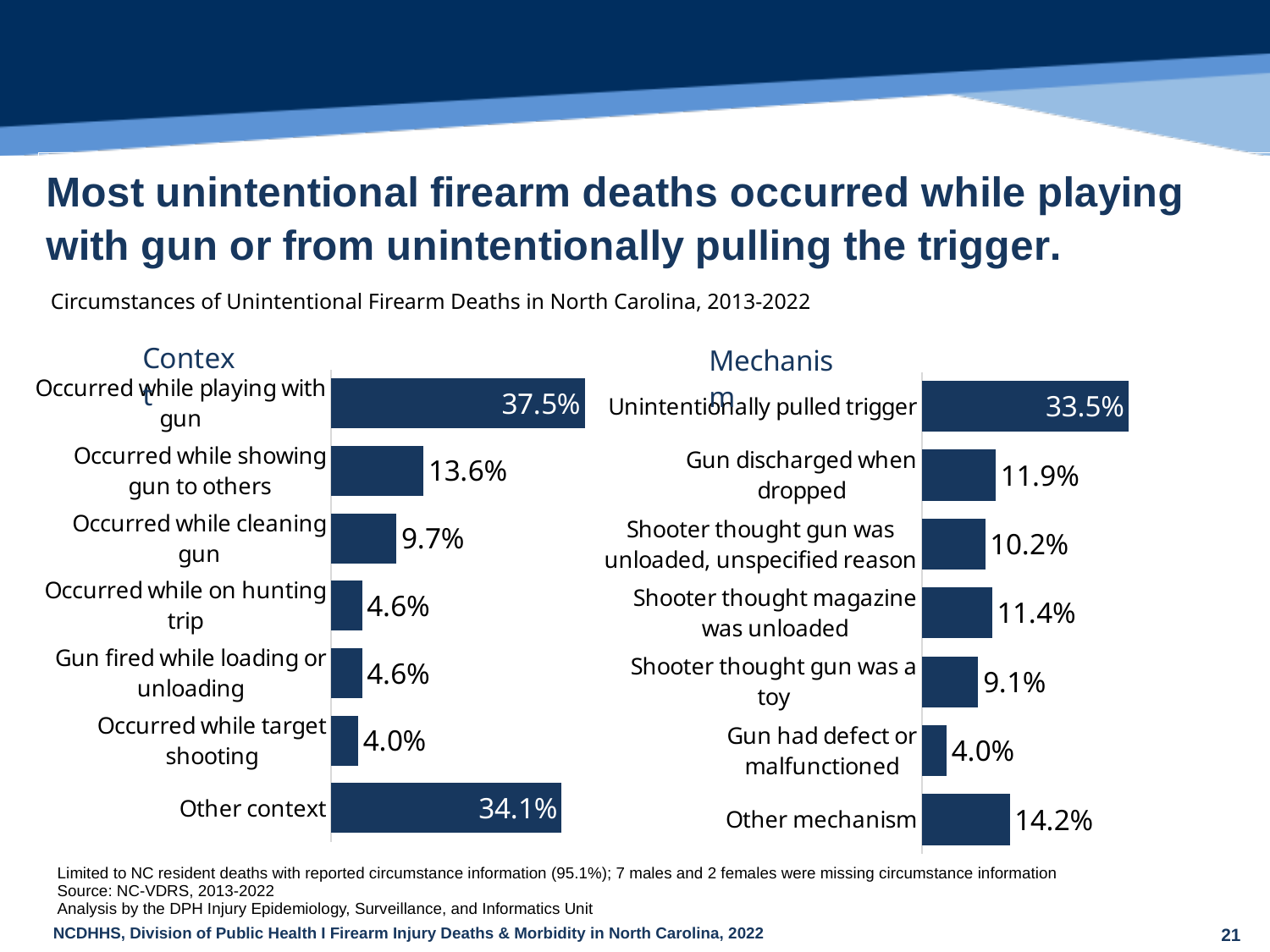
In the Context chart, what is the difference between 'Occurred while playing with gun' and 'Other context'? 3.4% What type of chart is the Mechanism chart? Bar chart In the Context chart, what percentage of unintentional firearm deaths occurred while playing with gun? 37.5% In the Mechanism chart, what is the difference between 'Unintentionally pulled trigger' and 'Other mechanism'? 19.3% In the Mechanism chart, what is the value for 'Gun discharged when dropped'? 11.9% In the Context chart, what is the value for 'Occurred while target shooting'? 4.0% In the Context chart, which category has the highest value? Occurred while playing with gun How many categories are shown in the Context chart? 7 How many categories are shown in the Mechanism chart? 7 In the Context chart, which is larger: 'Occurred while showing gun to others' or 'Occurred while cleaning gun'? Occurred while showing gun to others In the Mechanism chart, which is larger: 'Shooter thought magazine was unloaded' or 'Shooter thought gun was a toy'? Shooter thought magazine was unloaded In the Mechanism chart, which category has the lowest value? Gun had defect or malfunctioned